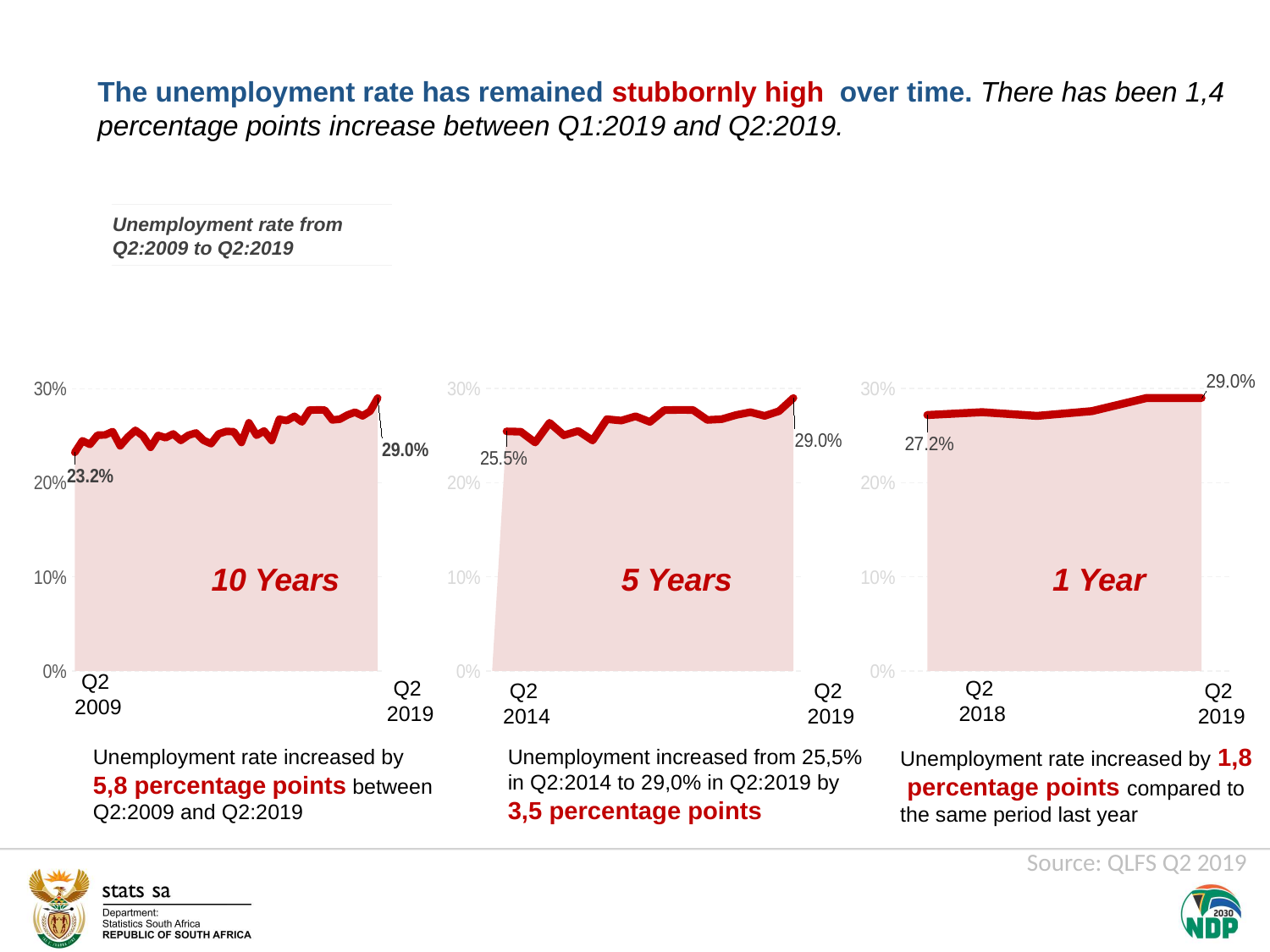
In the '1 Year' chart, what was the unemployment rate in Q2 2019? 29.0% In the '5 Years' chart, what was the unemployment rate in Q2 2014? 25.5% What kind of chart is the '5 Years' chart? area chart In the '10 Years' chart, what was the unemployment rate in Q2 2019? 29.0% In the '1 Year' chart, what was the unemployment rate in Q2 2018? 27.2% In the '1 Year' chart, what is the difference between the Q2 2019 and Q2 2018 unemployment rates? 1.8 percentage points In the '10 Years' chart, which is higher: the unemployment rate in Q2 2009 or in Q2 2019? Q2 2019 In the '10 Years' chart, what was the unemployment rate in Q2 2009? 23.2% In the '10 Years' chart, is the unemployment rate in Q2 2009 greater or less than 20%? greater In the '5 Years' chart, by how much did the unemployment rate rise from Q2 2014 to Q2 2019? 3.5 percentage points In the '1 Year' chart, does the unemployment rate rise or fall from Q2 2018 to Q2 2019? rise In the '10 Years' chart, what is the difference between the Q2 2019 and Q2 2009 unemployment rates? 5.8 percentage points